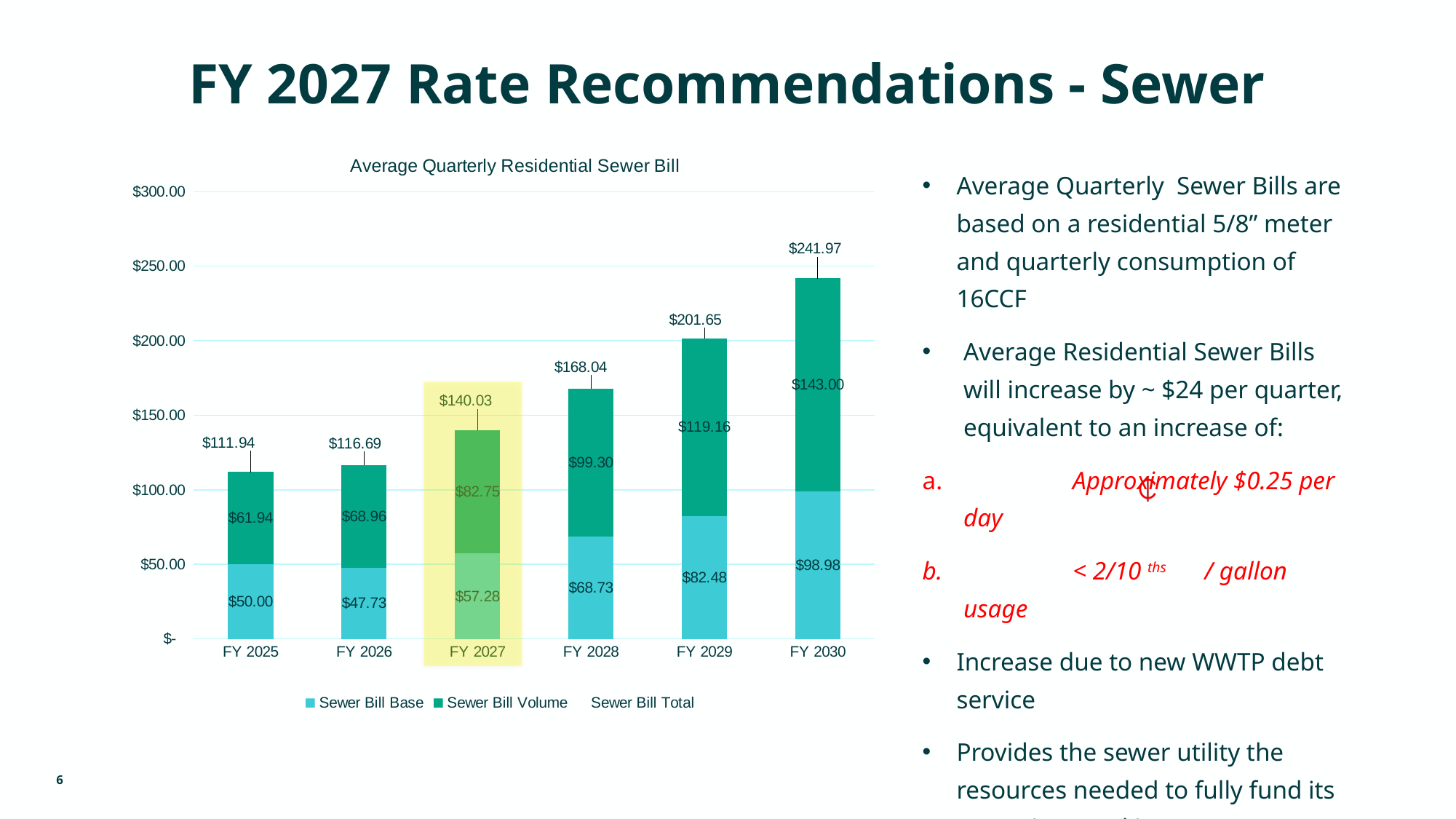
What is the Sewer Bill Volume value for FY 2029? $119.16 What kind of chart is shown on the slide? Stacked bar chart Which is larger, the Sewer Bill Volume for FY 2026 or the Sewer Bill Base for FY 2028? Sewer Bill Volume for FY 2026 Do the Sewer Bill Total values rise or fall from FY 2025 to FY 2030? Rise What is the difference between the Sewer Bill Total for FY 2028 and FY 2027? $28.01 Which fiscal year has the lowest Sewer Bill Base value? FY 2026 Which fiscal year has the highest Sewer Bill Total? FY 2030 What is the title of the chart? Average Quarterly Residential Sewer Bill What is the Sewer Bill Total for FY 2030? $241.97 What is the Sewer Bill Base value for FY 2027? $57.28 How many fiscal years are shown on the x axis? 6 How many series does the legend list? 3